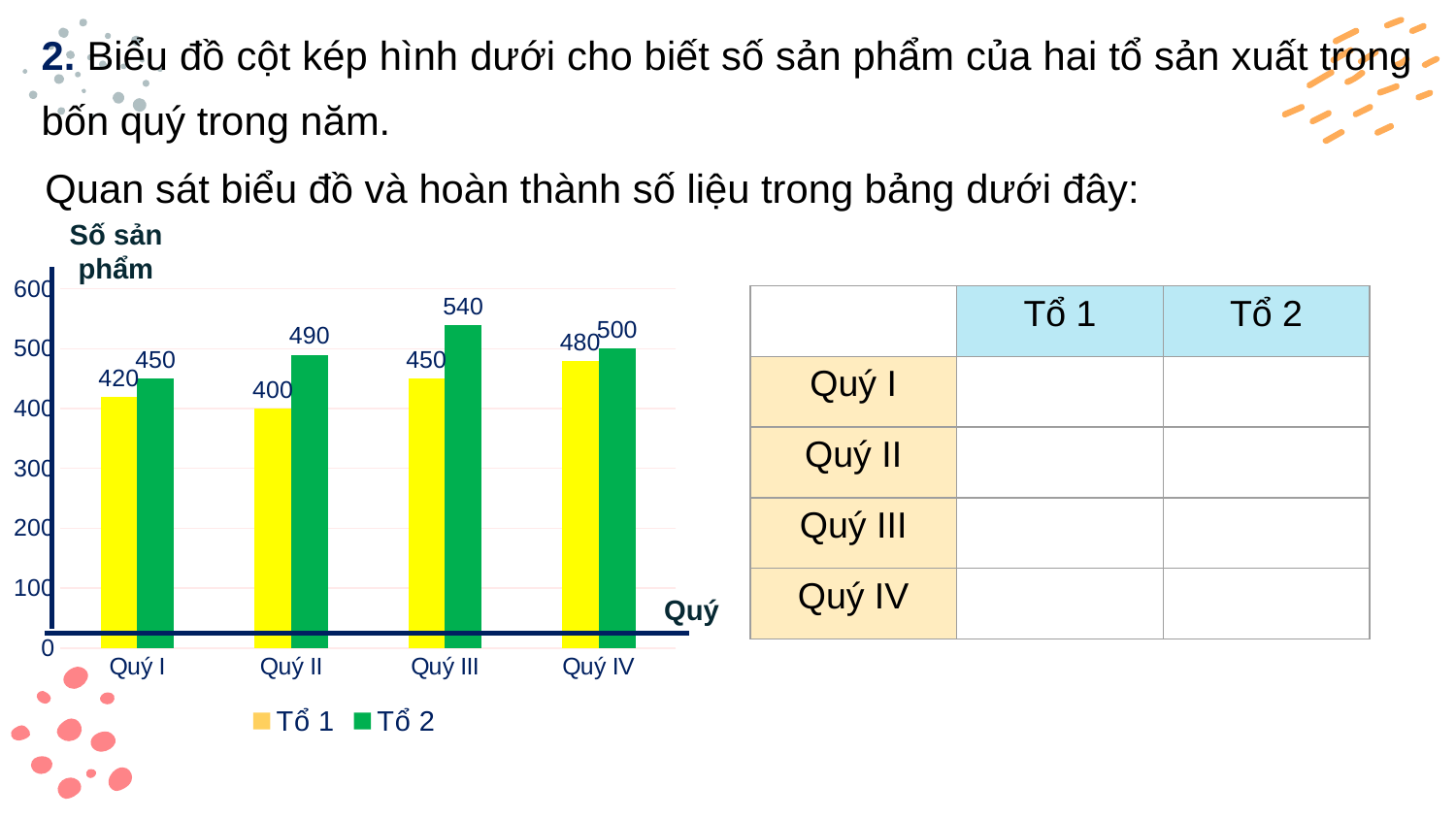
How many series does the legend list? 2 How many quarters are shown on the x axis? 4 What is the value for Tổ 2 in Quý III? 540 What kind of chart is shown? Bar chart Which is larger in Quý IV, Tổ 1 or Tổ 2? Tổ 2 What is the value for Tổ 1 in Quý IV? 480 What is the value for Tổ 1 in Quý I? 420 In which quarter is the value for Tổ 1 lowest? Quý II What is the difference between Tổ 2 and Tổ 1 in Quý II? 90 What is the value for Tổ 2 in Quý II? 490 In which quarter is the value for Tổ 2 highest? Quý III Do the values for Tổ 2 rise or fall from Quý I to Quý III? Rise